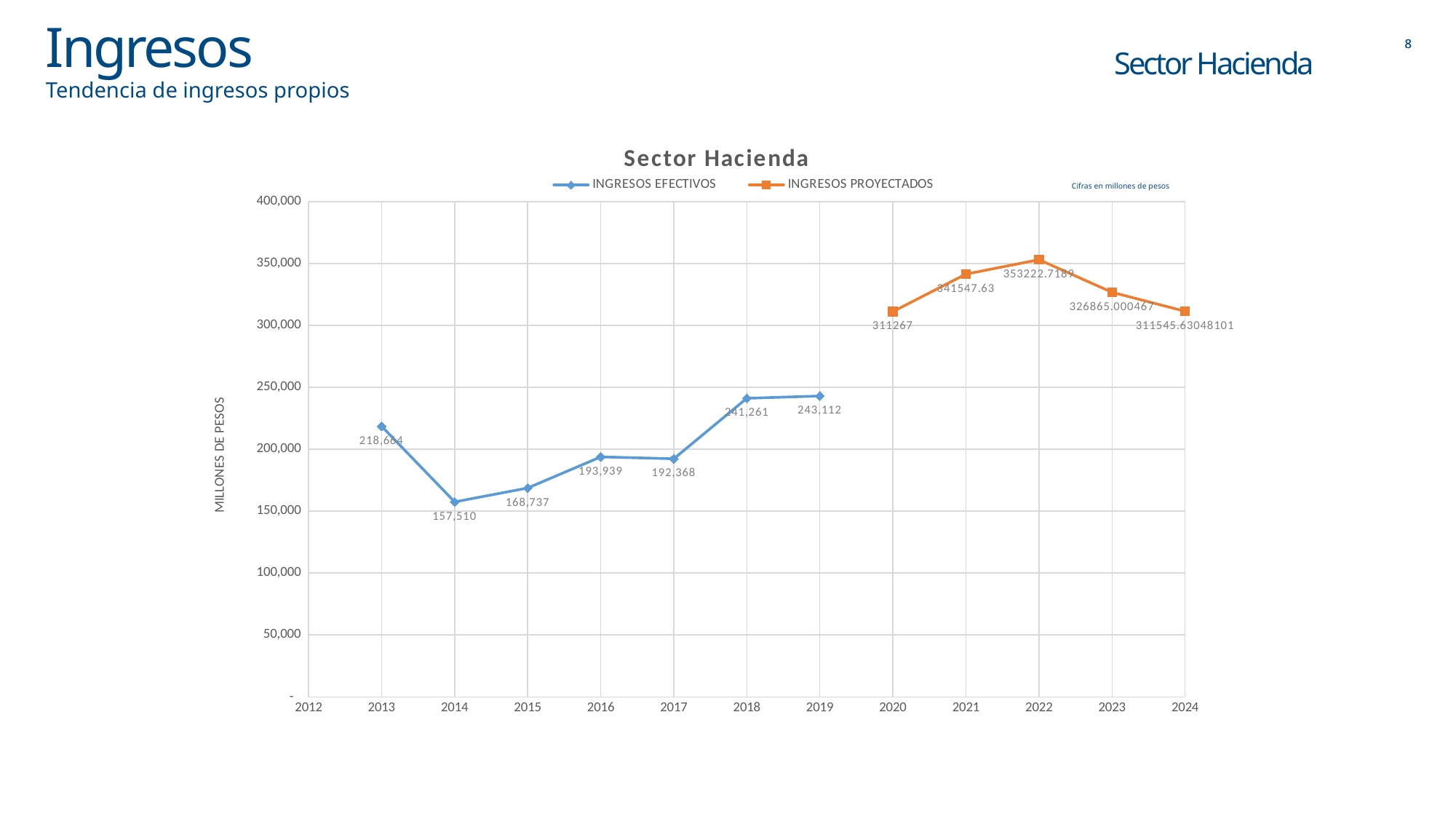
What is the value of INGRESOS EFECTIVOS for 2014? 157,510 What is the value of INGRESOS PROYECTADOS for 2022? 353222.7189 Is the value of INGRESOS PROYECTADOS for 2021 greater or less than 300,000? greater What is the difference between INGRESOS EFECTIVOS in 2015 and 2014? 11,227 Which year has the larger INGRESOS EFECTIVOS value, 2016 or 2017? 2016 What is the value of INGRESOS EFECTIVOS for 2019? 243,112 In which year is INGRESOS EFECTIVOS lowest? 2014 What is the difference between INGRESOS EFECTIVOS in 2019 and 2018? 1,851 What is the value of INGRESOS PROYECTADOS for 2020? 311267 How many series does the legend list? 2 How many data points does the INGRESOS EFECTIVOS series have? 7 In which year is INGRESOS PROYECTADOS highest? 2022